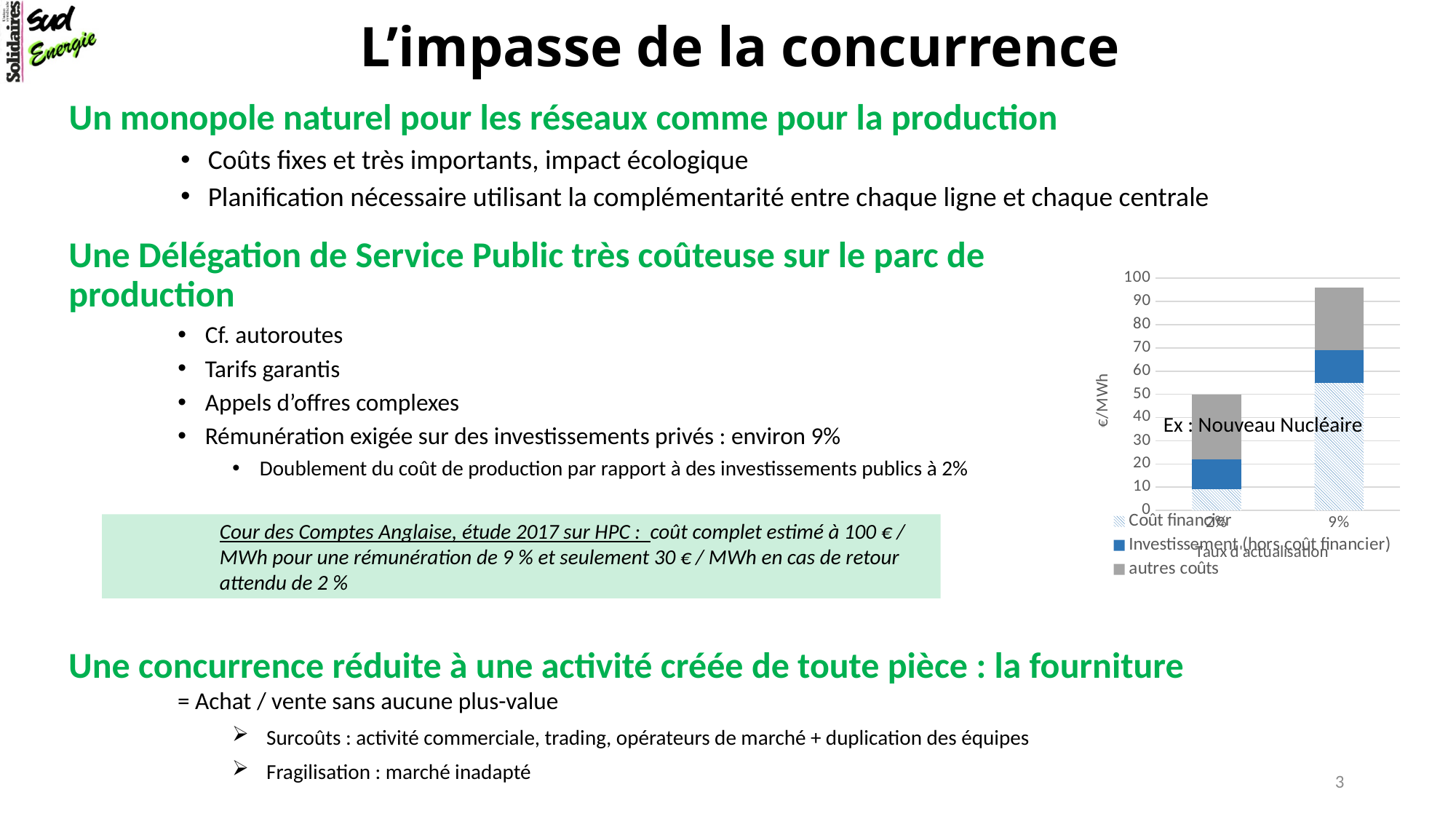
What kind of chart is shown on the slide? Stacked bar chart How many series does the chart legend list? 3 Is the total value for the 2% bar greater or less than 60? less Which category has the lowest total bar height? 2% How many categories are shown on the x axis of the chart? 2 Do the total bar values rise or fall from 2% to 9% along the x axis? rise Which category has the taller stacked bar, 2% or 9%? 9% Is the total value for the 2% bar greater or less than 40? greater Is the total value for the 9% bar greater or less than 90? greater What is the label of the vertical axis of the chart? €/MWh What is the label of the horizontal axis of the chart? Taux d'actualisation